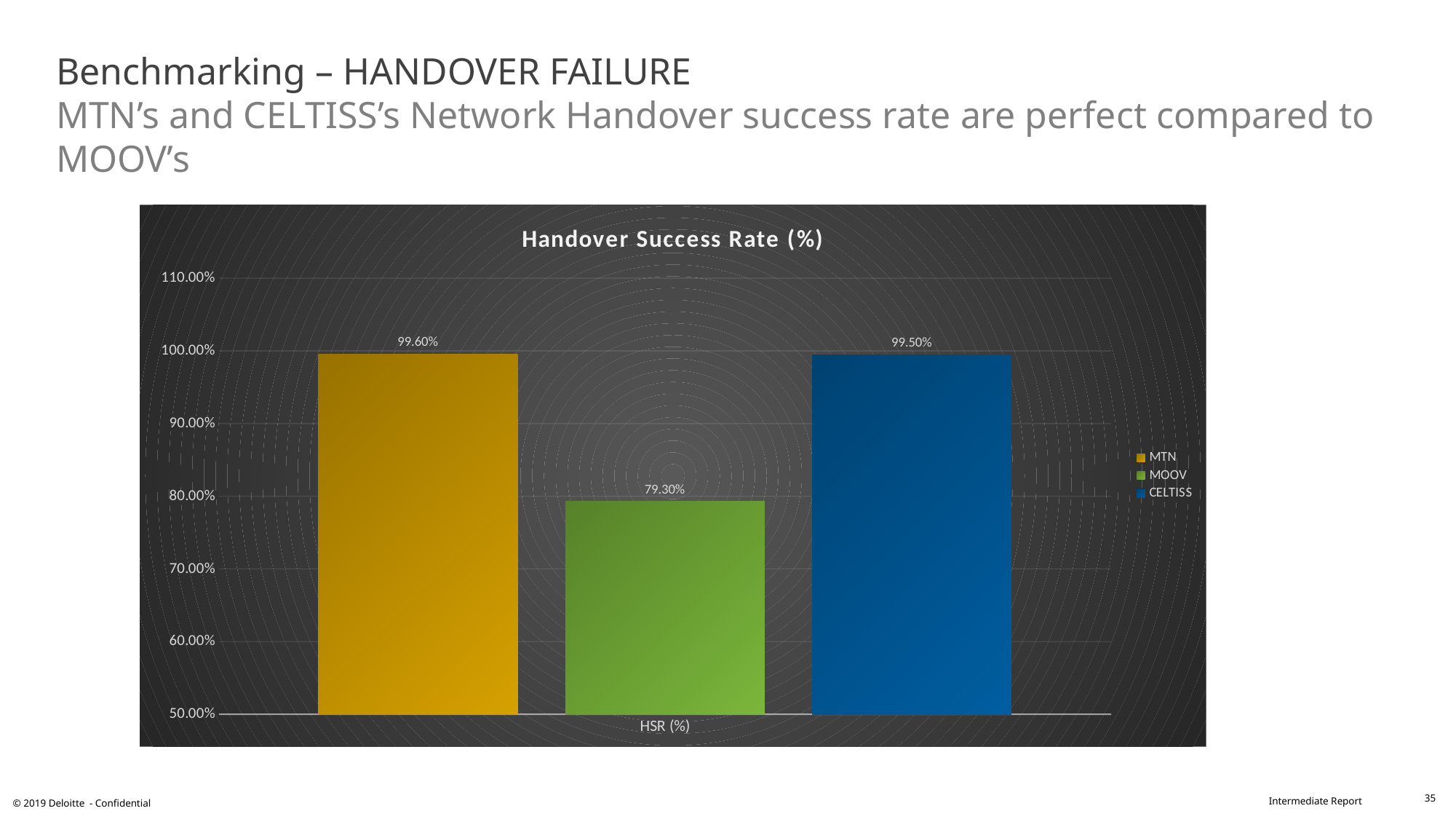
Which operator has the lowest Handover Success Rate? MOOV What is the Handover Success Rate for CELTISS? 99.50% Is the Handover Success Rate for MOOV greater or less than 80.00%? less What colour is the bar for CELTISS? Blue What is the Handover Success Rate for MOOV? 79.30% What is the Handover Success Rate for MTN? 99.60% How many series does the legend list? 3 What is the difference between MTN's and CELTISS's Handover Success Rate? 0.10% What is the difference between MTN's and MOOV's Handover Success Rate? 20.30% What kind of chart is shown on the slide? Bar chart Which has a higher Handover Success Rate, MOOV or CELTISS? CELTISS What is the title of the chart? Handover Success Rate (%)